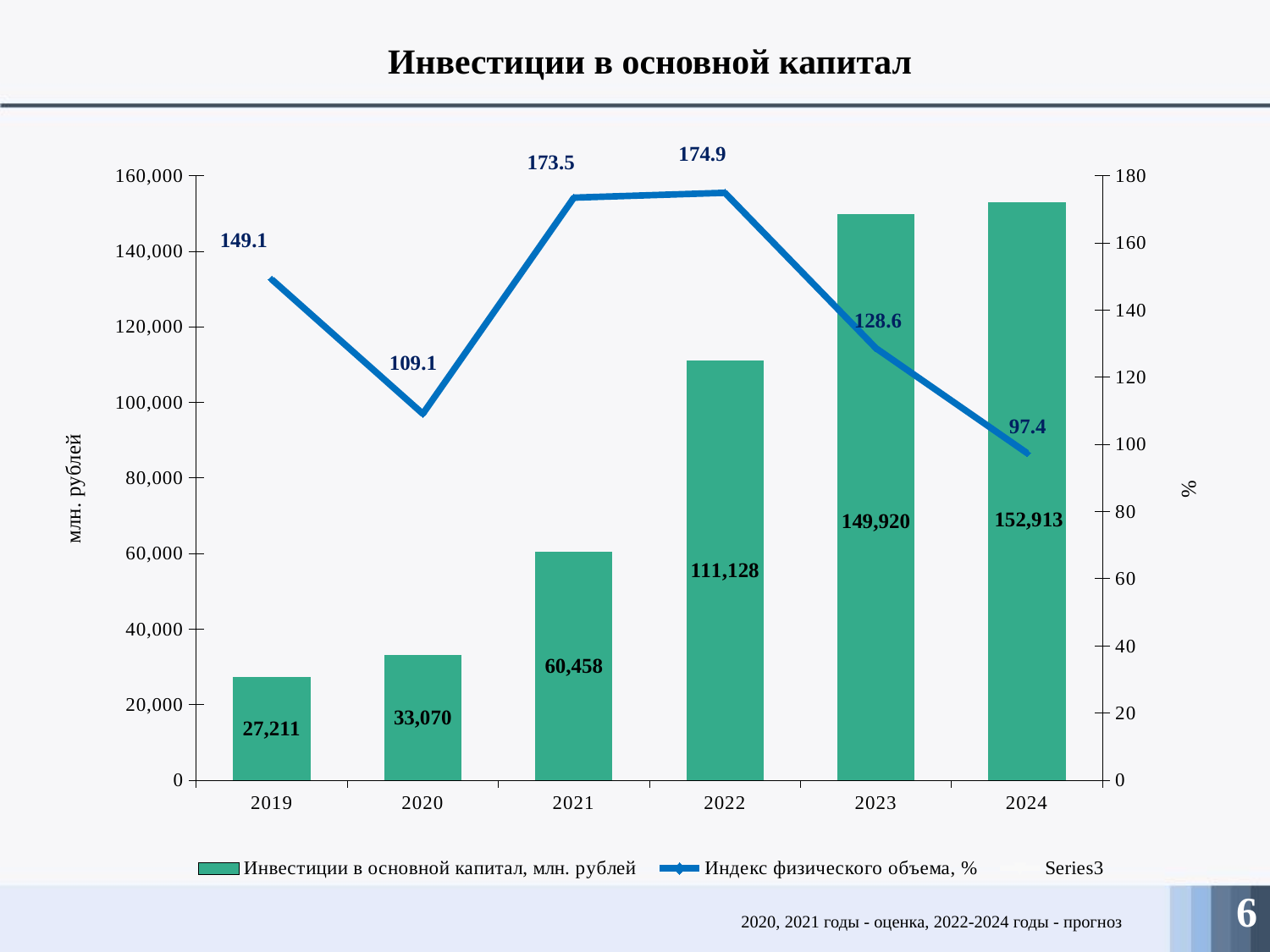
Which year has the lowest value of the physical volume index? 2024 Which is larger: the physical volume index for 2019 or for 2023? 2019 Do the investments in fixed capital rise or fall from 2019 to 2024? rise What is the difference between investments in fixed capital in 2024 and 2023? 2,993 Which year has the highest value of investments in fixed capital? 2024 How many years are shown on the x axis? 6 What is the value of the physical volume index (Индекс физического объема, %) for 2021? 173.5 What is the title of the chart? Инвестиции в основной капитал What is the value of investments in fixed capital (Инвестиции в основной капитал, млн. рублей) for 2022? 111,128 Which year has the highest value of the physical volume index? 2022 How many series does the legend list? 3 What is the value of investments in fixed capital for 2019? 27,211